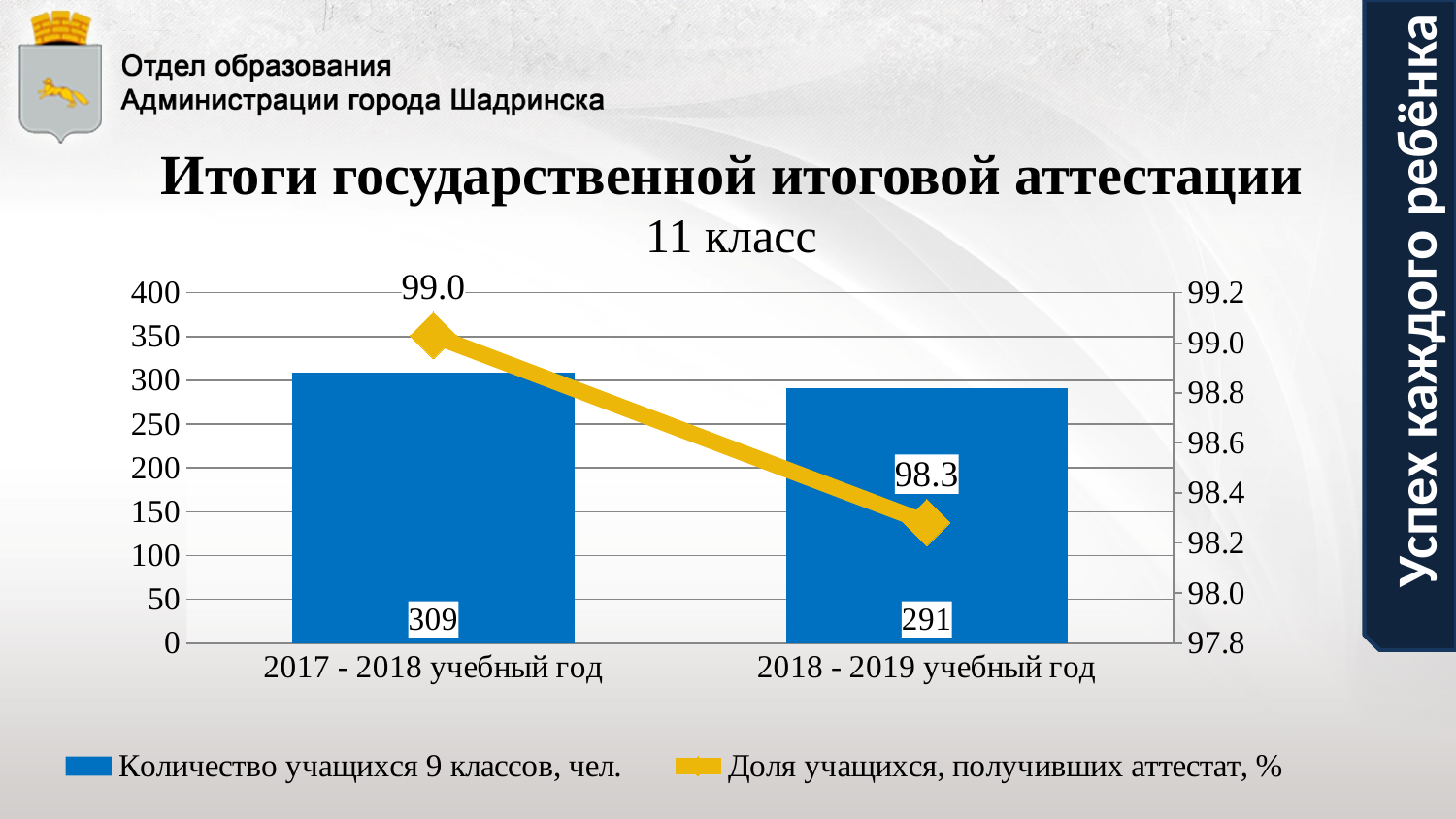
What is the share of students who received a certificate (Доля учащихся, получивших аттестат, %) in the 2018 - 2019 учебный год? 98.3 What is the number of students (Количество учащихся) for the 2018 - 2019 учебный год? 291 How many series does the legend list? 2 What is the share of students who received a certificate (Доля учащихся, получивших аттестат, %) in the 2017 - 2018 учебный год? 99.0 Is the number of students in 2018 - 2019 greater or less than 300? less What is the number of students (Количество учащихся) for the 2017 - 2018 учебный год? 309 Does the share of students who received a certificate rise or fall from 2017 - 2018 to 2018 - 2019? fall How many school years (categories) are shown on the x axis? 2 What is the difference in the share of students who received a certificate between 2017 - 2018 and 2018 - 2019? 0.7 Which school year has the lower share of students who received a certificate? 2018 - 2019 учебный год Which school year has the higher number of students (Количество учащихся)? 2017 - 2018 учебный год By how much did the number of students decrease from 2017 - 2018 to 2018 - 2019? 18